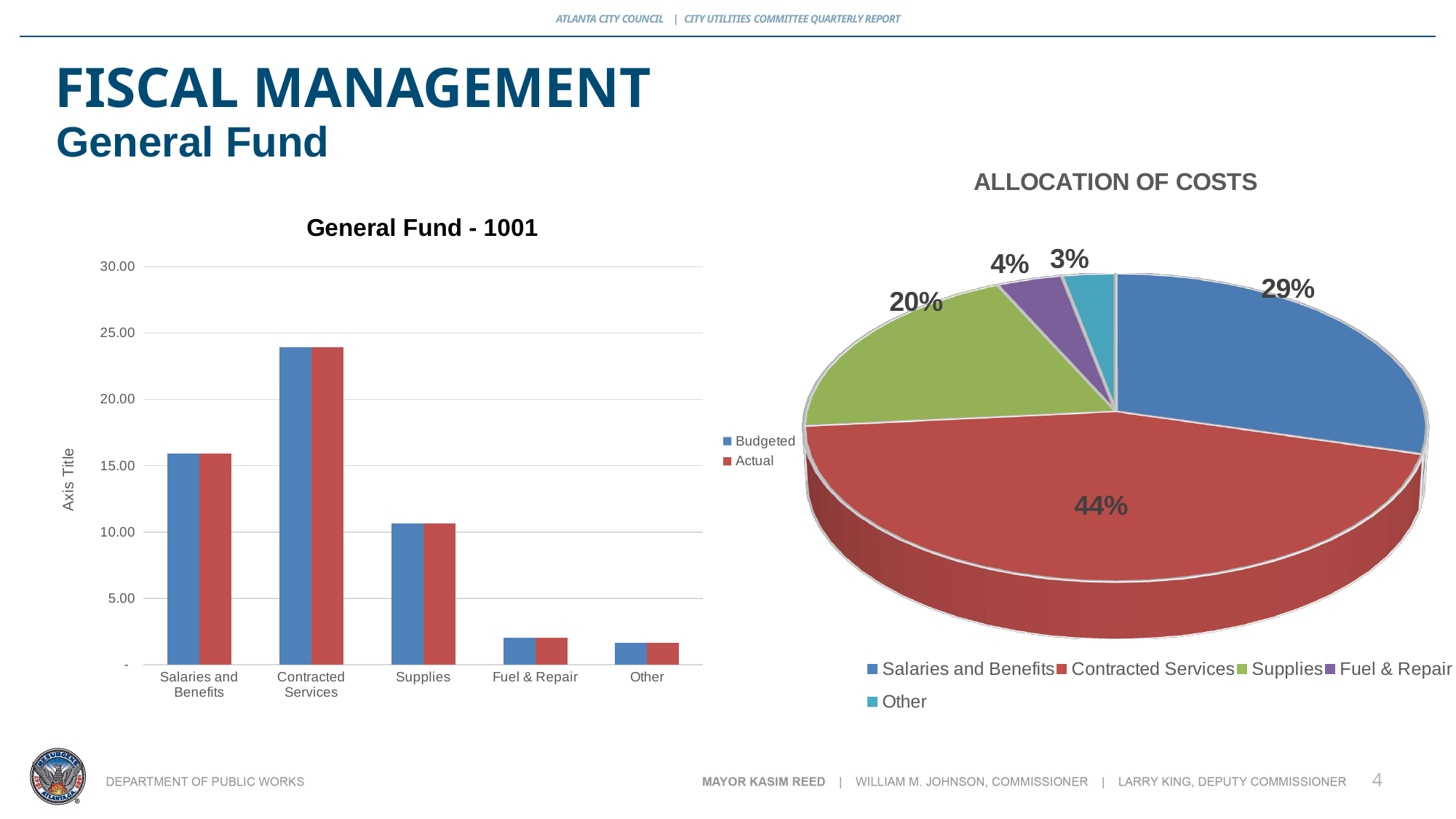
In the General Fund - 1001 chart, which category has the highest bars? Contracted Services In the General Fund - 1001 chart, is the Actual value for Fuel & Repair greater or less than 5.00? less In the ALLOCATION OF COSTS pie chart, what share is Supplies? 20% In the General Fund - 1001 chart, is the Budgeted value for Contracted Services greater or less than 20.00? greater In the ALLOCATION OF COSTS pie chart, what share is Contracted Services? 44% How many slices does the ALLOCATION OF COSTS pie chart have? 5 In the ALLOCATION OF COSTS pie chart, how many percentage points larger is Contracted Services than Salaries and Benefits? 15 In the ALLOCATION OF COSTS pie chart, which category has the smallest share? Other In the ALLOCATION OF COSTS pie chart, what share is Salaries and Benefits? 29% In the ALLOCATION OF COSTS pie chart, which category has the largest share? Contracted Services How many series does the legend of the General Fund - 1001 chart list? 2 What kind of chart is General Fund - 1001? Bar chart